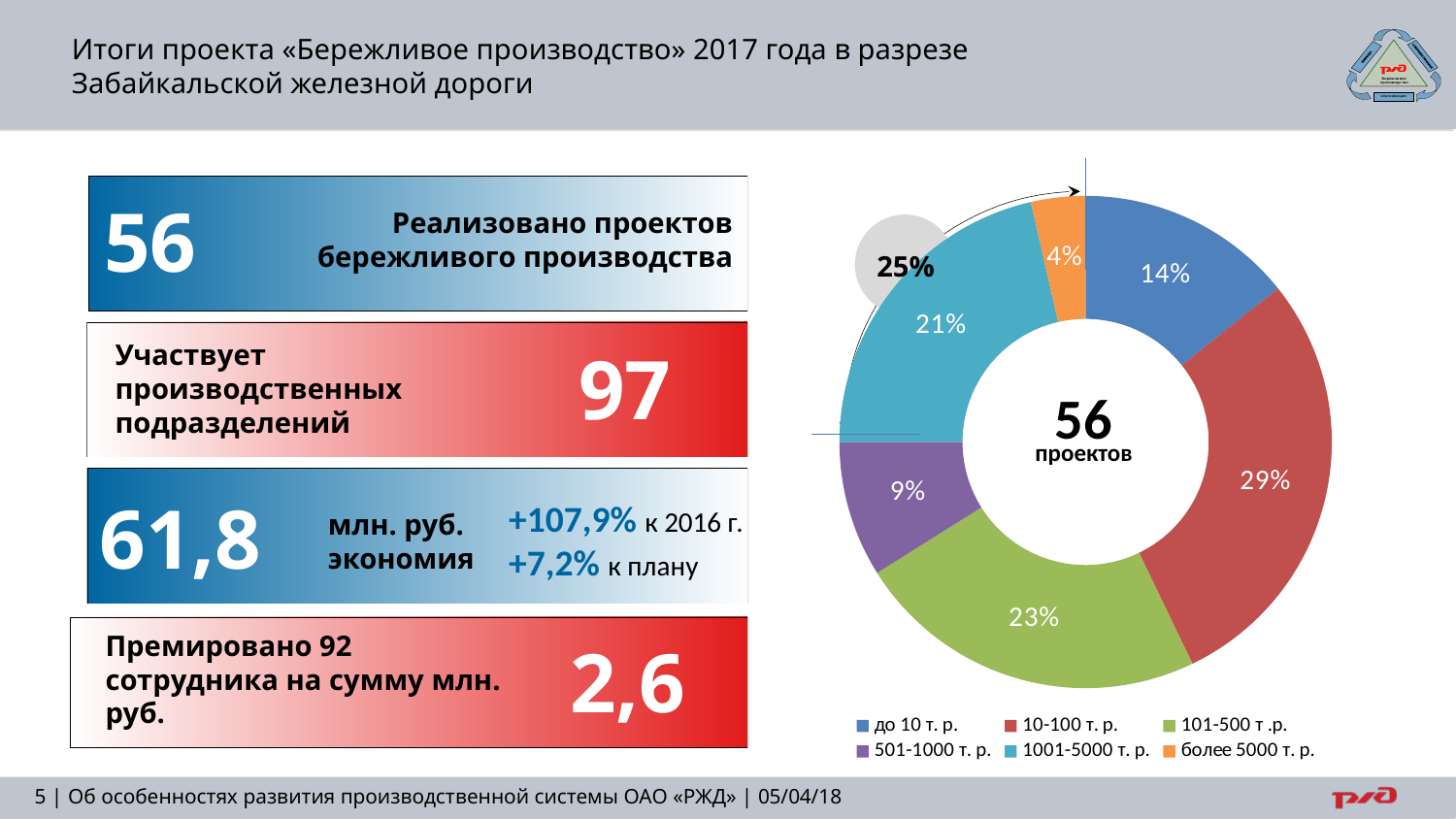
How many categories does the legend of the doughnut chart list? 6 What share of the doughnut chart does the category «1001-5000 т. р.» have? 21% Which category has the largest share in the doughnut chart? 10-100 т. р. In the doughnut chart, what is the difference between the shares of «101-500 т. р.» and «501-1000 т. р.»? 14% What colour is the «101-500 т. р.» slice in the doughnut chart? green What kind of chart is shown on the right side of the slide? doughnut (pie) chart Which category has the smallest share in the doughnut chart? более 5000 т. р. What share of the doughnut chart does the category «более 5000 т. р.» have? 4% What number is shown in the centre of the doughnut chart? 56 проектов What share of the doughnut chart does the category «до 10 т. р.» have? 14% What share of the doughnut chart does the category «10-100 т. р.» have? 29% In the doughnut chart, which share is larger: «до 10 т. р.» or «1001-5000 т. р.»? 1001-5000 т. р.